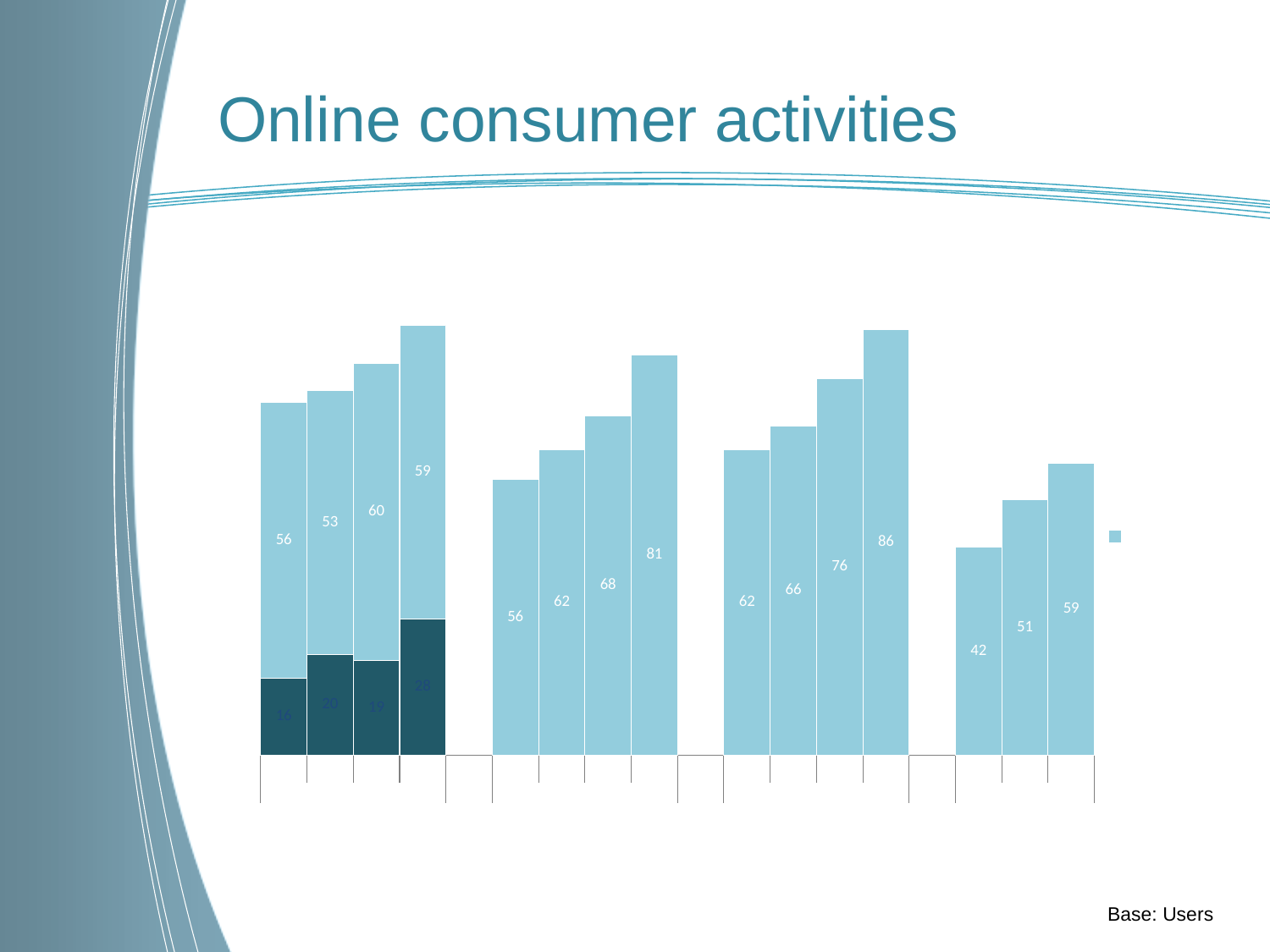
What is the value of the tallest bar in the second group from the left? 81 What is the lowest light-blue data label shown in the chart? 42 Which group of bars contains a second, dark-blue stacked series? the leftmost group What is the value of the first bar in the rightmost group? 42 Which is larger: the last bar of the second group (81) or the last bar of the rightmost group (59)? 81 Do the light-blue values rise or fall from left to right within the third group of bars? rise How many groups of bars are shown in the chart? 4 What is the title of the slide containing the chart? Online consumer activities What kind of chart is shown on the slide? bar chart What is the highest light-blue data label shown in the chart? 86 What is the difference between the tallest bar in the third group (86) and the tallest bar in the second group (81)? 5 How many bars are in the rightmost group of the chart? 3